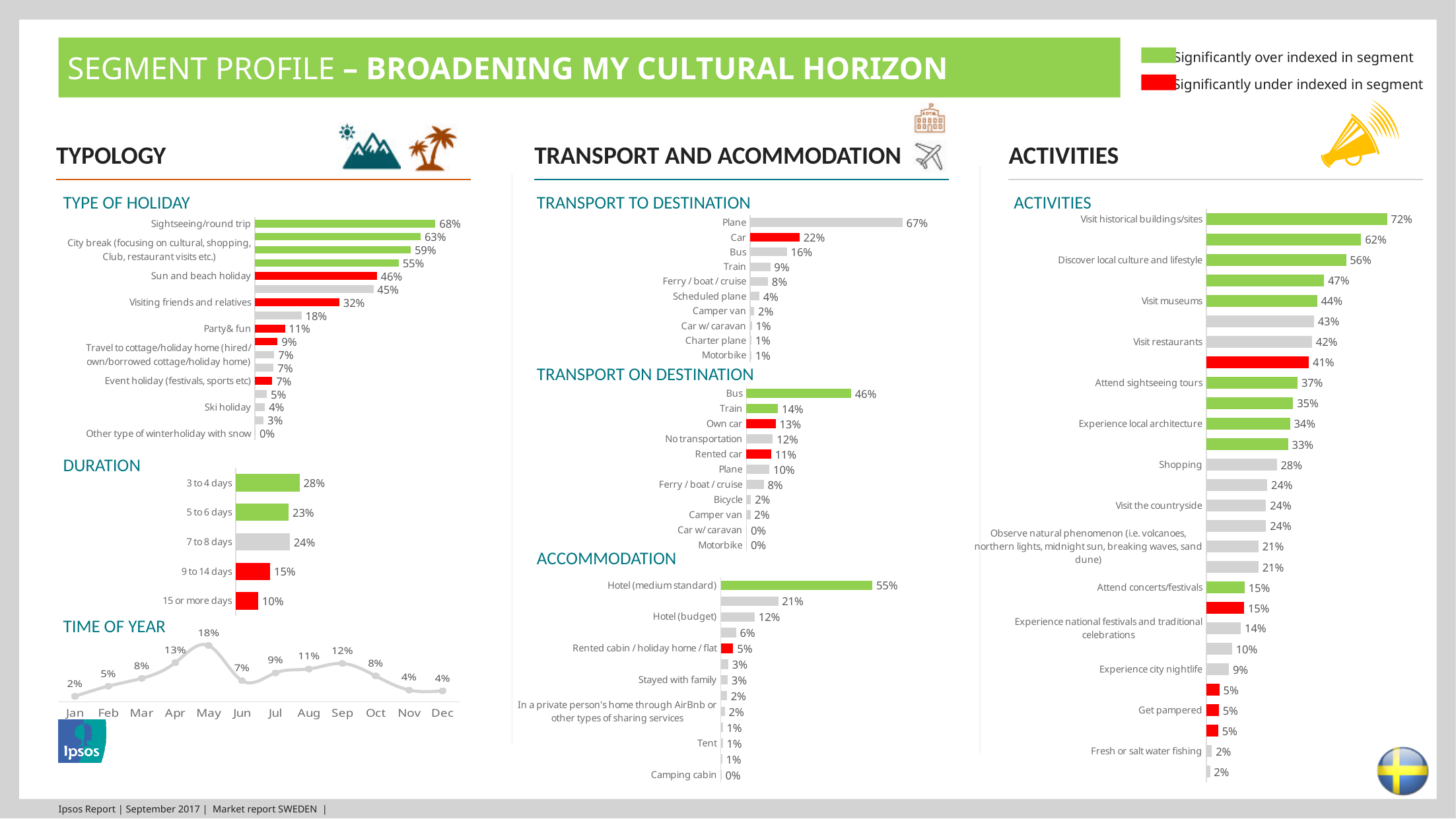
In the Transport to Destination chart, which category has the highest value? Plane In the Activities chart, what is the value for Visit historical buildings/sites? 72% In the Transport on Destination chart, which is larger, the value for Own car or the value for Rented car? Own car In the Accommodation chart, what is the value for Hotel (medium standard)? 55% In the Duration chart, which category has the highest value? 3 to 4 days In the Transport to Destination chart, what is the value for Plane? 67% In the Duration chart, how many categories are shown? 5 In the Time of Year chart, which month has the highest value? May In the Duration chart, what is the difference between the values for 3 to 4 days and 9 to 14 days? 13% What kind of chart is the Time of Year chart? line chart In the Transport on Destination chart, what is the value for Bus? 46% In the Time of Year chart, what is the value for Jan? 2%